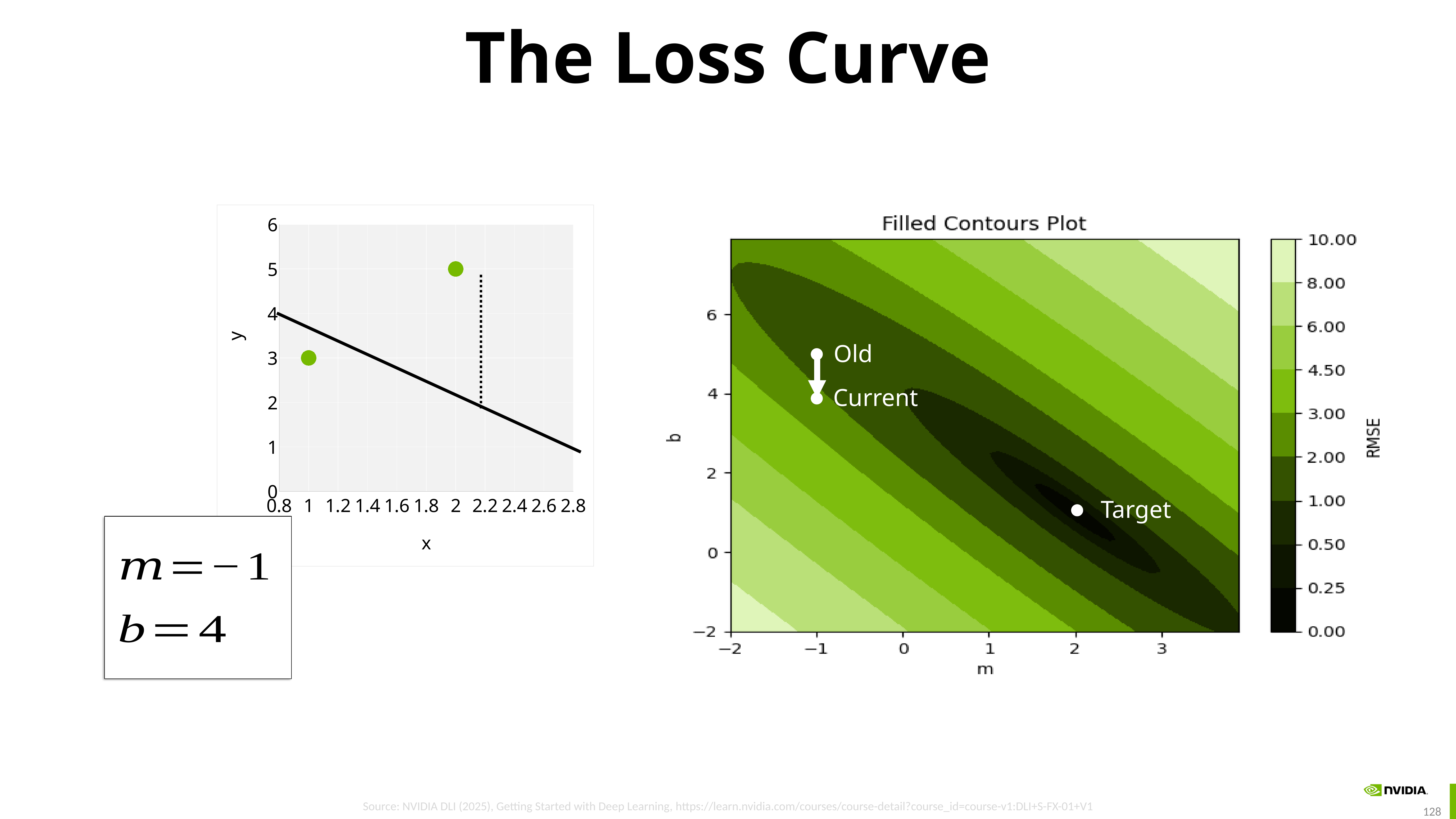
In the chart on the left, what is the y value of the data point at x = 1? 3 In the Filled Contours Plot, which labelled point has the highest b value? Old In the chart on the left, does the black line rise or fall as x increases? Falls In the chart on the left, what is the y value of the data point at x = 2? 5 What kind of chart is the chart on the left of the slide? Scatter plot with a fitted line In the chart on the left, what is the difference in y between the data point at x = 2 and the data point at x = 1? 2 What is the title of the chart on the right of the slide? Filled Contours Plot In the Filled Contours Plot, what quantity does the colour bar represent? RMSE In the chart on the left, which data point has the higher y value, the one at x = 1 or the one at x = 2? The one at x = 2 In the chart on the left, how many green data points are plotted? 2 In the Filled Contours Plot, what is the maximum value shown on the colour bar? 10.00